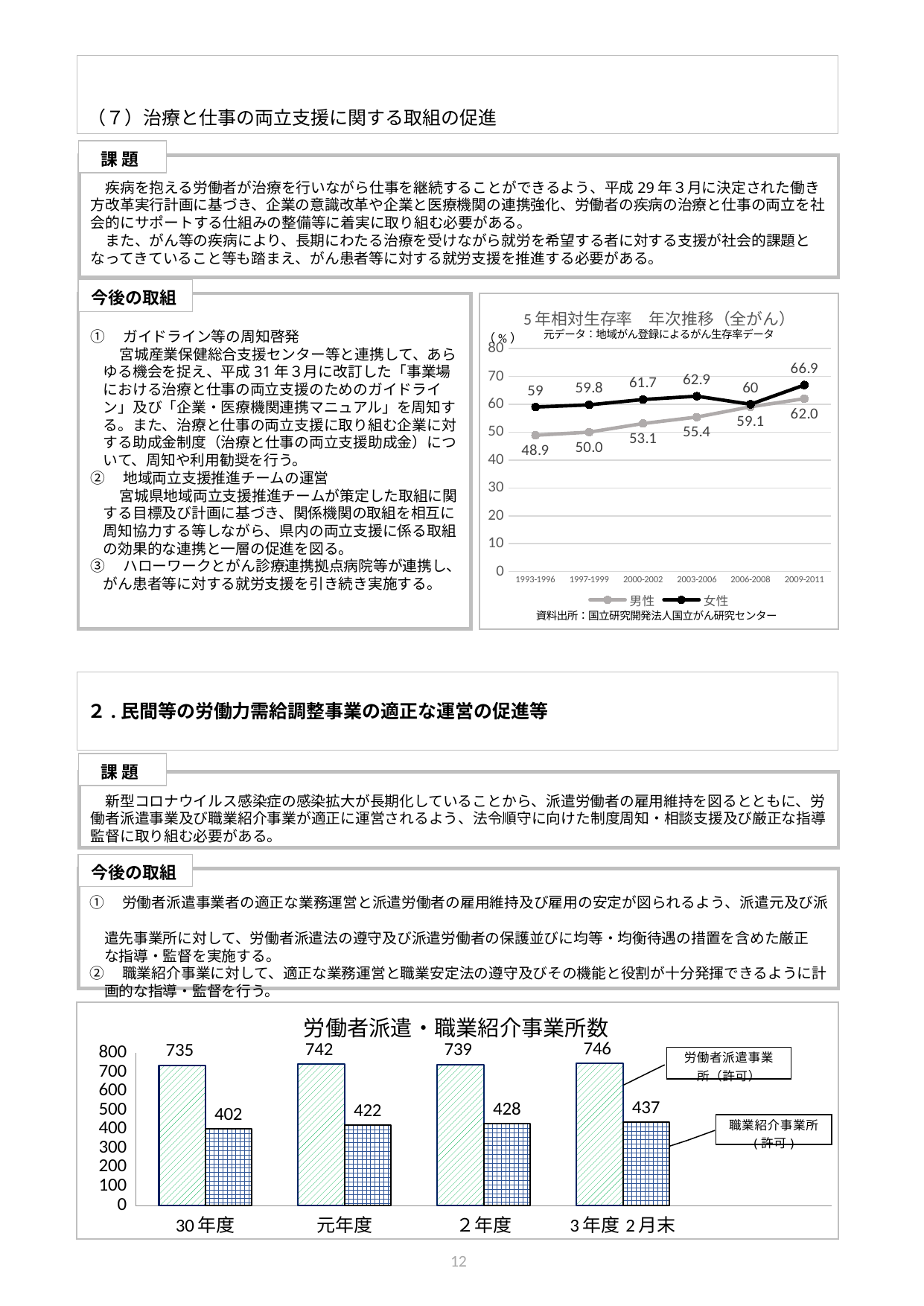
In the line chart titled 5年相対生存率 年次推移（全がん）, what is the value for 男性 in 2009-2011? 62.0 In the line chart titled 5年相対生存率 年次推移（全がん）, how many series does the legend list? 2 In the bar chart titled 労働者派遣・職業紹介事業所数, what is the value for 労働者派遣事業所（許可） in 元年度? 742 In the line chart titled 5年相対生存率 年次推移（全がん）, what is the difference between 女性 and 男性 in 2009-2011? 4.9 In the bar chart titled 労働者派遣・職業紹介事業所数, which period has the highest value for 労働者派遣事業所（許可）? 3年度2月末 In the bar chart titled 労働者派遣・職業紹介事業所数, what is the value for 職業紹介事業所（許可） in 3年度2月末? 437 In the line chart titled 5年相対生存率 年次推移（全がん）, what is the value for 女性 in 1993-1996? 59 In the line chart titled 5年相対生存率 年次推移（全がん）, how many periods are shown on the x axis? 6 In the bar chart titled 労働者派遣・職業紹介事業所数, what is the difference between 労働者派遣事業所（許可） and 職業紹介事業所（許可） in 30年度? 333 In the line chart titled 5年相対生存率 年次推移（全がん）, which period has the lowest value for 男性? 1993-1996 What kind of chart is 労働者派遣・職業紹介事業所数? bar chart In the line chart titled 5年相対生存率 年次推移（全がん）, does the value for 男性 rise or fall from 1993-1996 to 2009-2011? rise